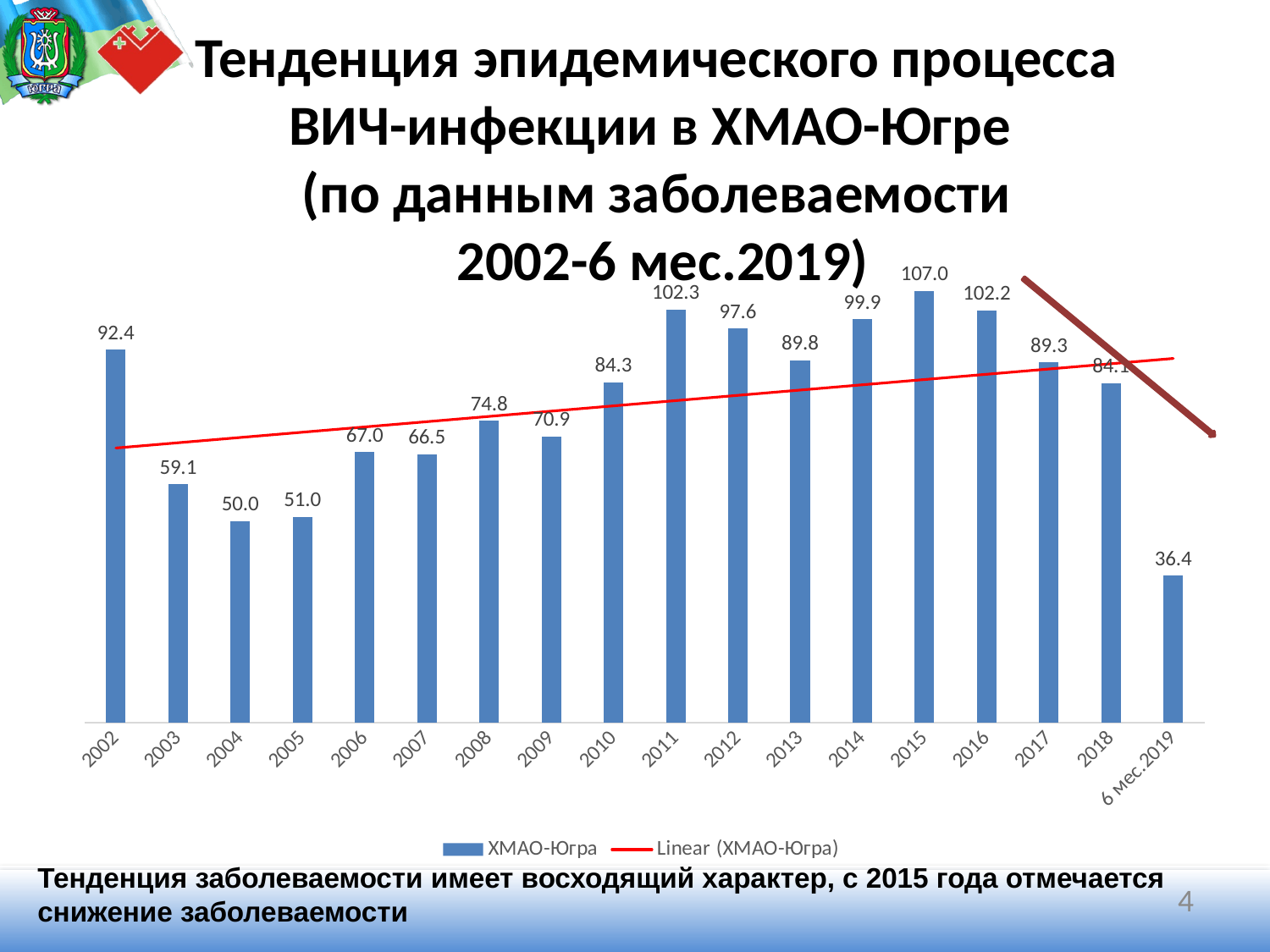
What kind of chart is shown on the slide? Bar chart How many entries does the legend list? 2 Which is larger, the value for 2012 or the value for 2014? 2014 What is the difference between the values for 2015 and 2018? 22.9 What is the value for 6 мес.2019? 36.4 What is the value for 2004? 50.0 Which year has the highest value? 2015 How many categories are shown on the x axis? 18 What is the value for 2015? 107.0 Which category has the lowest value? 6 мес.2019 What is the value for 2011? 102.3 What is the name of the bar series in the legend? ХМАО-Югра